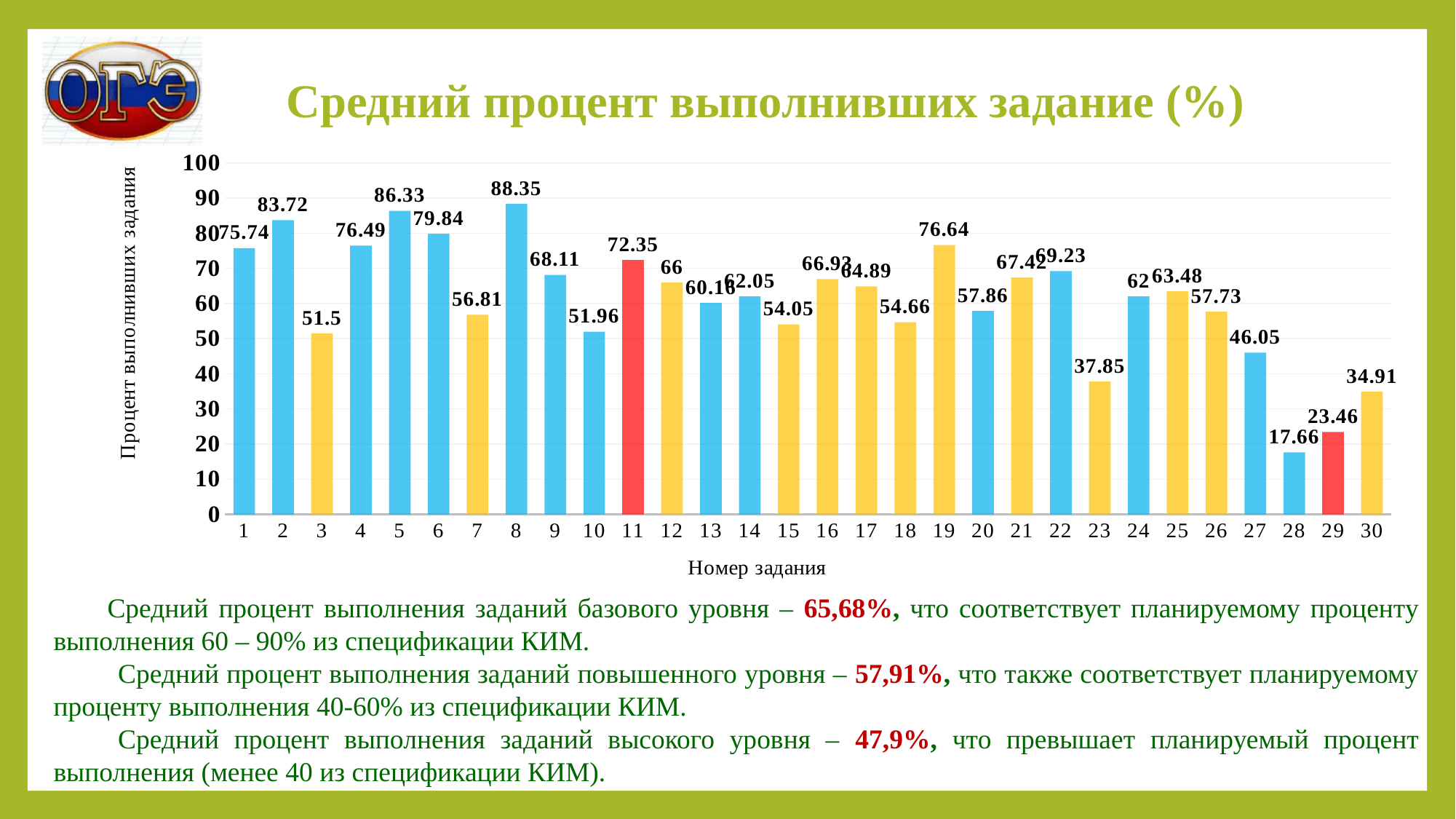
What is the value for task 19? 76.64 Is the value for task 23 greater or less than 40? less What is the difference between the values for task 11 and task 30? 37.44 Which task number has the lowest value? 28 What is the difference between the values for task 5 and task 3? 34.83 What is the value for task 29? 23.46 Which has a larger value, task 2 or task 6? task 2 How many task numbers are shown on the x axis? 30 What kind of chart is shown on the slide? bar chart What colour are the bars for tasks 11 and 29? red Which task number has the highest value? 8 What is the value for task 8? 88.35